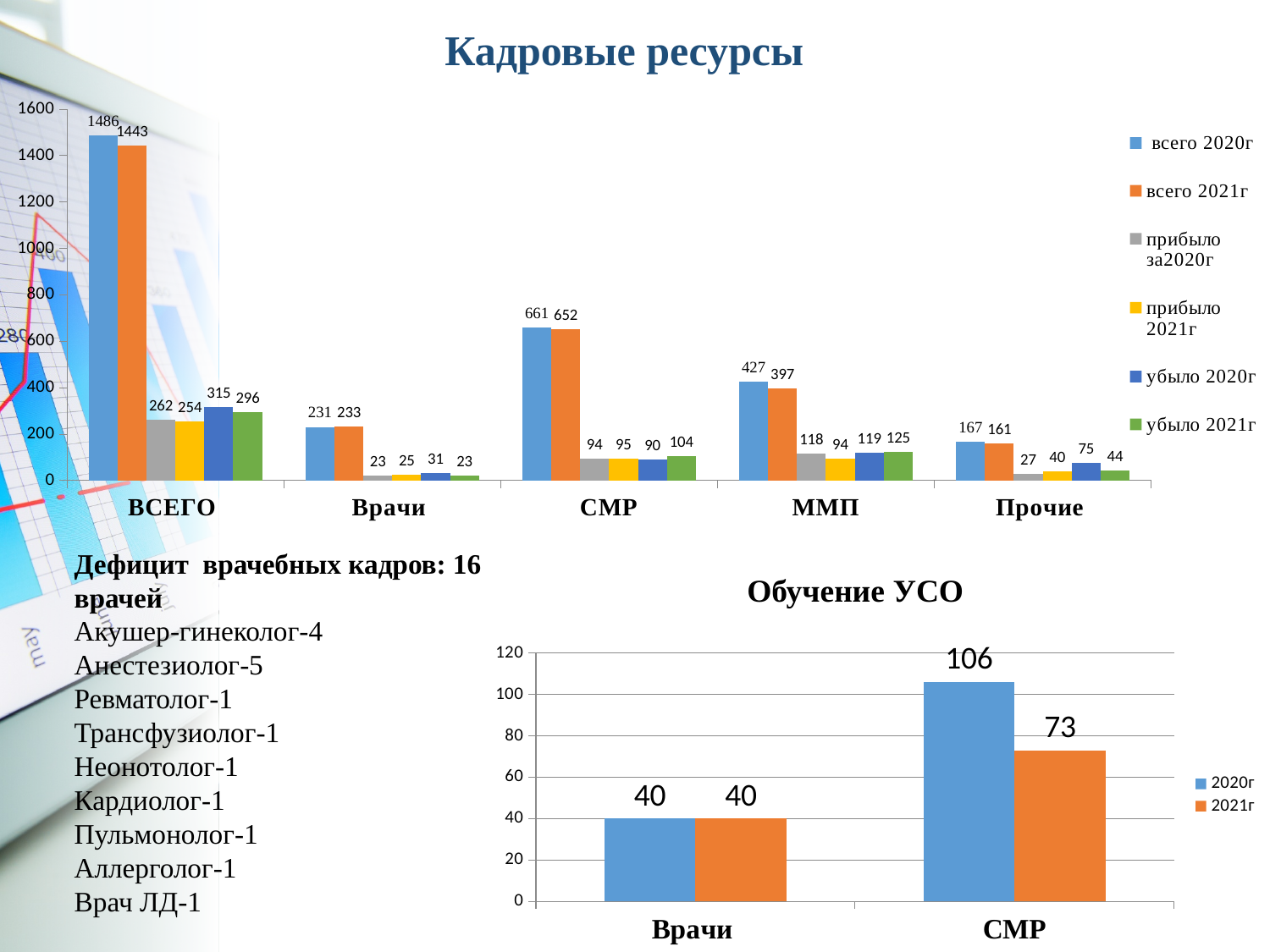
In the top chart, which is larger for Прочие: 'убыло 2020г' or 'убыло 2021г'? убыло 2020г In the top chart, how many categories are shown on the x axis? 5 In the top chart, which category has the lowest 'всего 2021г' value? Прочие In the top chart, what is the value of 'прибыло 2021г' for ММП? 94 In the bottom chart 'Обучение УСО', what is the difference between 2020г and 2021г for СМР? 33 What type of chart is the bottom chart 'Обучение УСО'? bar chart In the top chart, what is the value of 'убыло 2021г' for СМР? 104 In the bottom chart 'Обучение УСО', what is the value for СМР in 2020г? 106 In the top chart, what is the difference between 'всего 2020г' and 'всего 2021г' for ММП? 30 In the top chart, what is the value of 'всего 2020г' for ВСЕГО? 1486 In the top chart, how many series does the legend list? 6 What is the title of the bottom chart? Обучение УСО